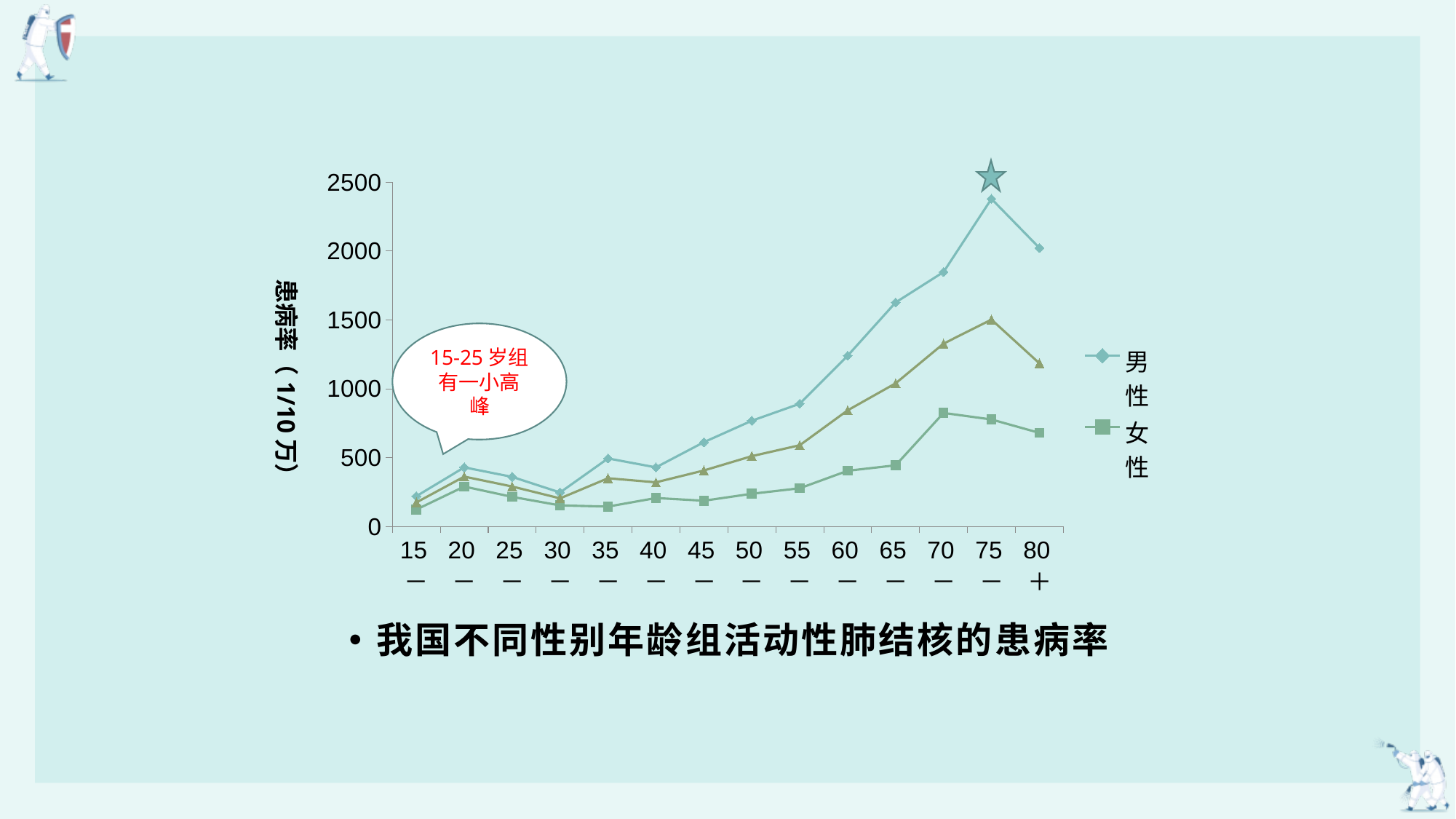
Is the value for 男性 in the 75- age group greater or less than 2000? greater In the 60- age group, which series has the larger value, 男性 or 女性? 男性 Is the value for 男性 in the 15- age group greater or less than 500? less How many series does the legend list? 2 In which age group does the 女性 series reach its highest value? 70- How many age groups are shown along the x axis? 14 In which age group does the 男性 series reach its highest value? 75- Does the 女性 series rise or fall from the 70- age group to the 80+ age group? fall What is the caption text below the chart? 我国不同性别年龄组活动性肺结核的患病率 Does the 男性 series rise or fall from the 55- age group to the 75- age group? rise Is the value for 女性 in the 75- age group greater or less than 1000? less What kind of chart is shown on the slide? line chart